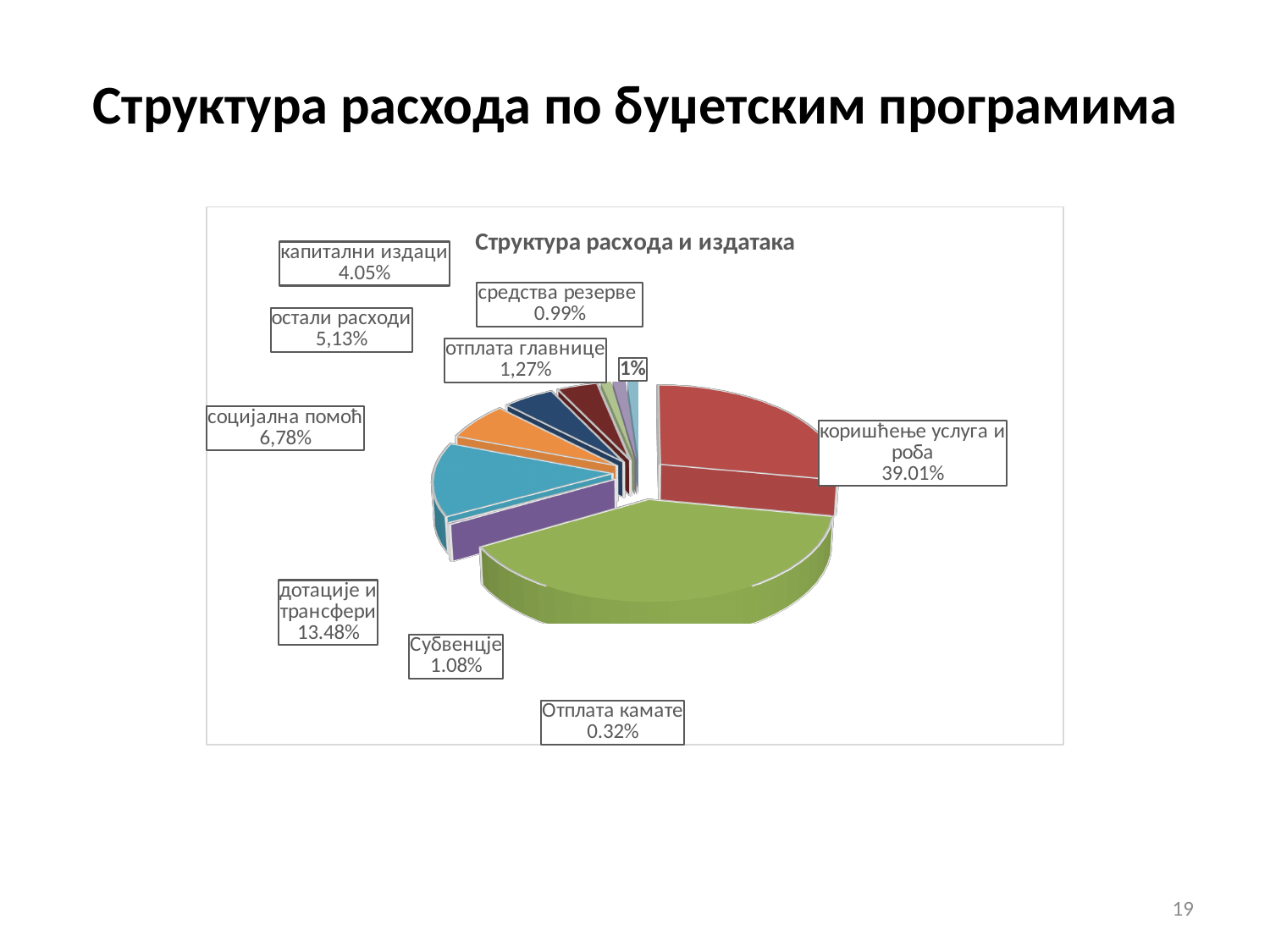
What is the value shown for социјална помоћ? 6,78% Which labeled slice has the smallest share? Отплата камате What is the value shown for средства резерве? 0.99% What is the value shown for отплата главнице? 1,27% What is the value shown for капитални издаци? 4.05% What share does дотације и трансфери have in the pie chart? 13.48% What kind of chart is shown on the slide? pie chart Which is larger, остали расходи or капитални издаци? остали расходи What is the title of the chart? Структура расхода и издатака What share does коришћење услуга и роба have in the pie chart? 39.01% What is the difference in percentage points between коришћење услуга и роба and дотације и трансфери? 25.53 What is the value shown for Отплата камате? 0.32%